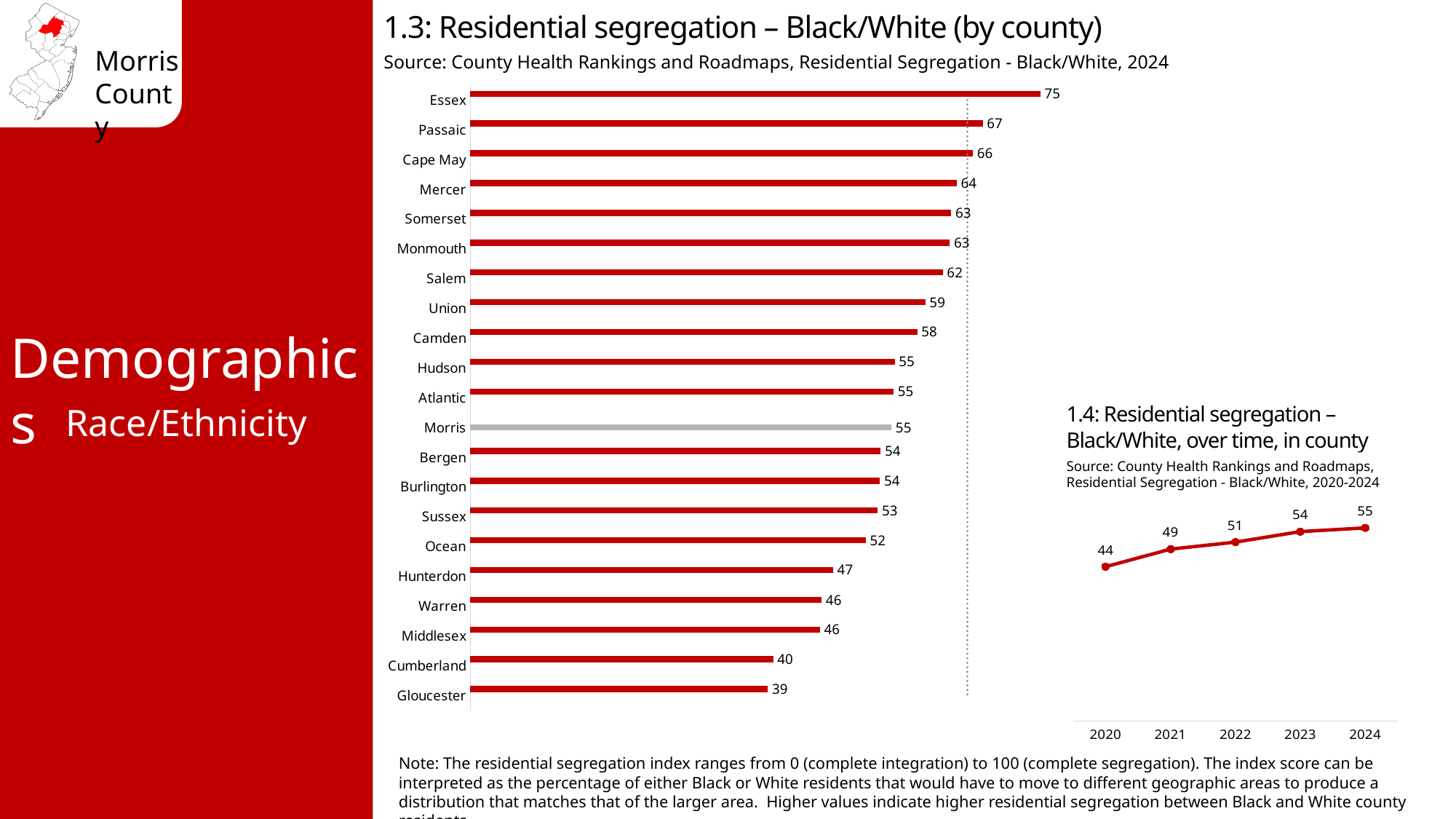
In the chart '1.3: Residential segregation – Black/White (by county)', how many counties are shown? 21 In the chart '1.3: Residential segregation – Black/White (by county)', which county's bar is shown in grey rather than red? Morris In the chart '1.4: Residential segregation – Black/White, over time, in county', what is the difference between the 2024 and 2020 values? 11 In the chart '1.3: Residential segregation – Black/White (by county)', what is the value for Morris? 55 In the chart '1.3: Residential segregation – Black/White (by county)', what is the difference between the values for Essex and Gloucester? 36 In the chart '1.3: Residential segregation – Black/White (by county)', which county has the highest value? Essex In the chart '1.3: Residential segregation – Black/White (by county)', which county has the lowest value? Gloucester In the chart '1.4: Residential segregation – Black/White, over time, in county', what is the value for 2020? 44 In the chart '1.3: Residential segregation – Black/White (by county)', which has a larger value, Passaic or Hunterdon? Passaic In the chart '1.4: Residential segregation – Black/White, over time, in county', do the values rise or fall from 2020 to 2024? Rise In the chart '1.3: Residential segregation – Black/White (by county)', what is the value for Cumberland? 40 What kind of chart is '1.3: Residential segregation – Black/White (by county)'? Bar chart